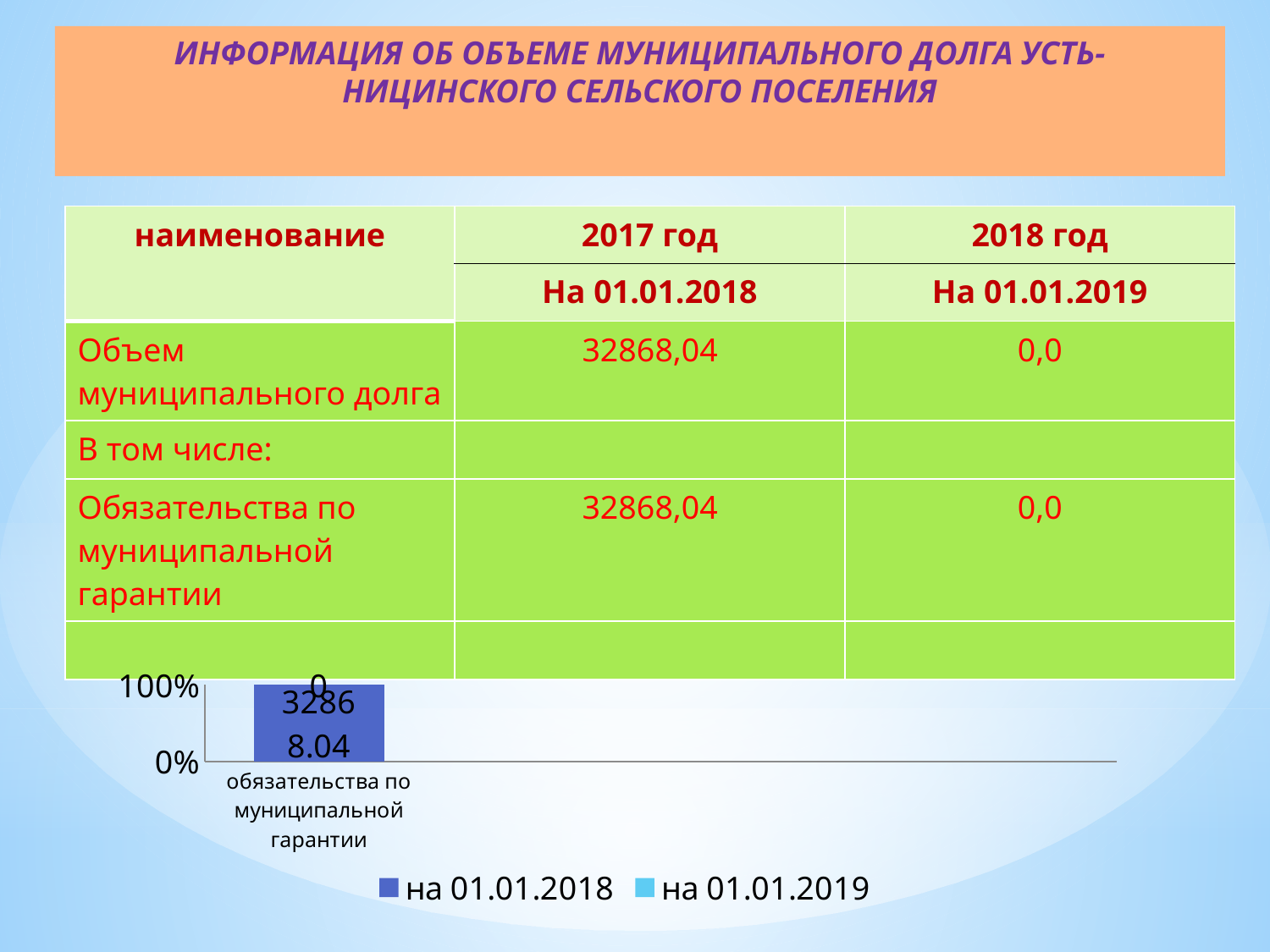
What are the two tick labels shown on the y axis of the chart? 0% and 100% What is the data label for the series 'на 01.01.2018' in the chart? 32868.04 What is the data label for the series 'на 01.01.2019' in the chart? 0 How many categories are plotted on the x axis of the chart? 1 In the chart, which series has the larger value for 'обязательства по муниципальной гарантии': 'на 01.01.2018' or 'на 01.01.2019'? на 01.01.2018 What is the category label shown on the x axis of the chart? обязательства по муниципальной гарантии What colour represents the series 'на 01.01.2018' in the chart legend? dark blue How many series does the legend of the chart list? 2 What kind of chart is shown at the bottom of the slide? bar chart